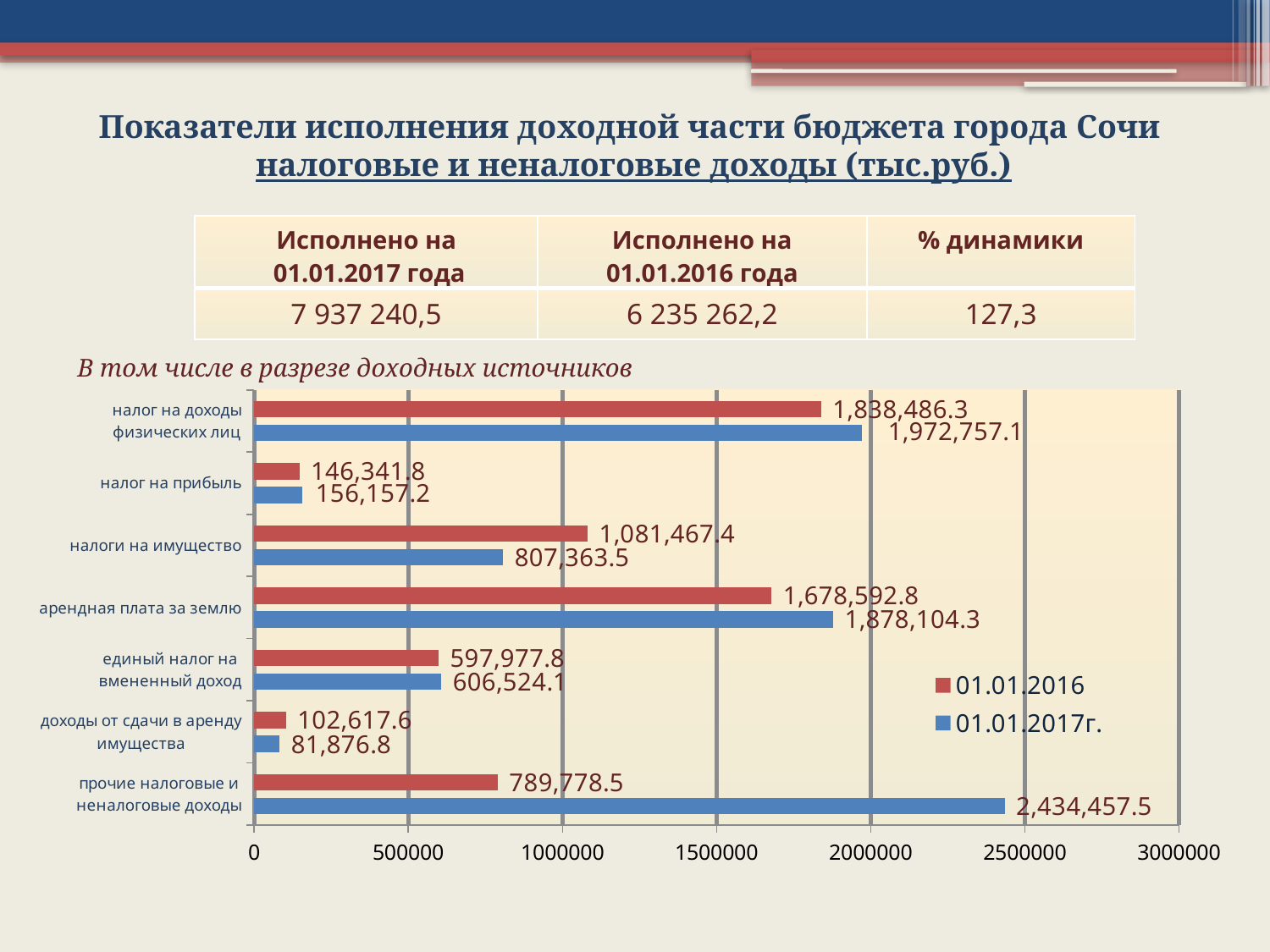
Which category has the highest value in the 01.01.2017г. series? прочие налоговые и неналоговые доходы How many series does the chart legend list? 2 Which category has the lowest value in the 01.01.2016 series? доходы от сдачи в аренду имущества What is the difference between the 01.01.2016 and 01.01.2017г. values for налоги на имущество? 274,103.9 What is the value for налог на доходы физических лиц in the 01.01.2017г. series? 1,972,757.1 How many categories are shown on the chart? 7 What type of chart is shown on the slide? bar chart For арендная плата за землю, which series has the larger value: 01.01.2016 or 01.01.2017г.? 01.01.2017г. What is the value for прочие налоговые и неналоговые доходы in the 01.01.2017г. series? 2,434,457.5 Is the 01.01.2016 value for налог на доходы физических лиц greater or less than 1500000? greater What is the value for налоги на имущество in the 01.01.2016 series? 1,081,467.4 What is the difference between the 01.01.2017г. and 01.01.2016 values for прочие налоговые и неналоговые доходы? 1,644,679.0